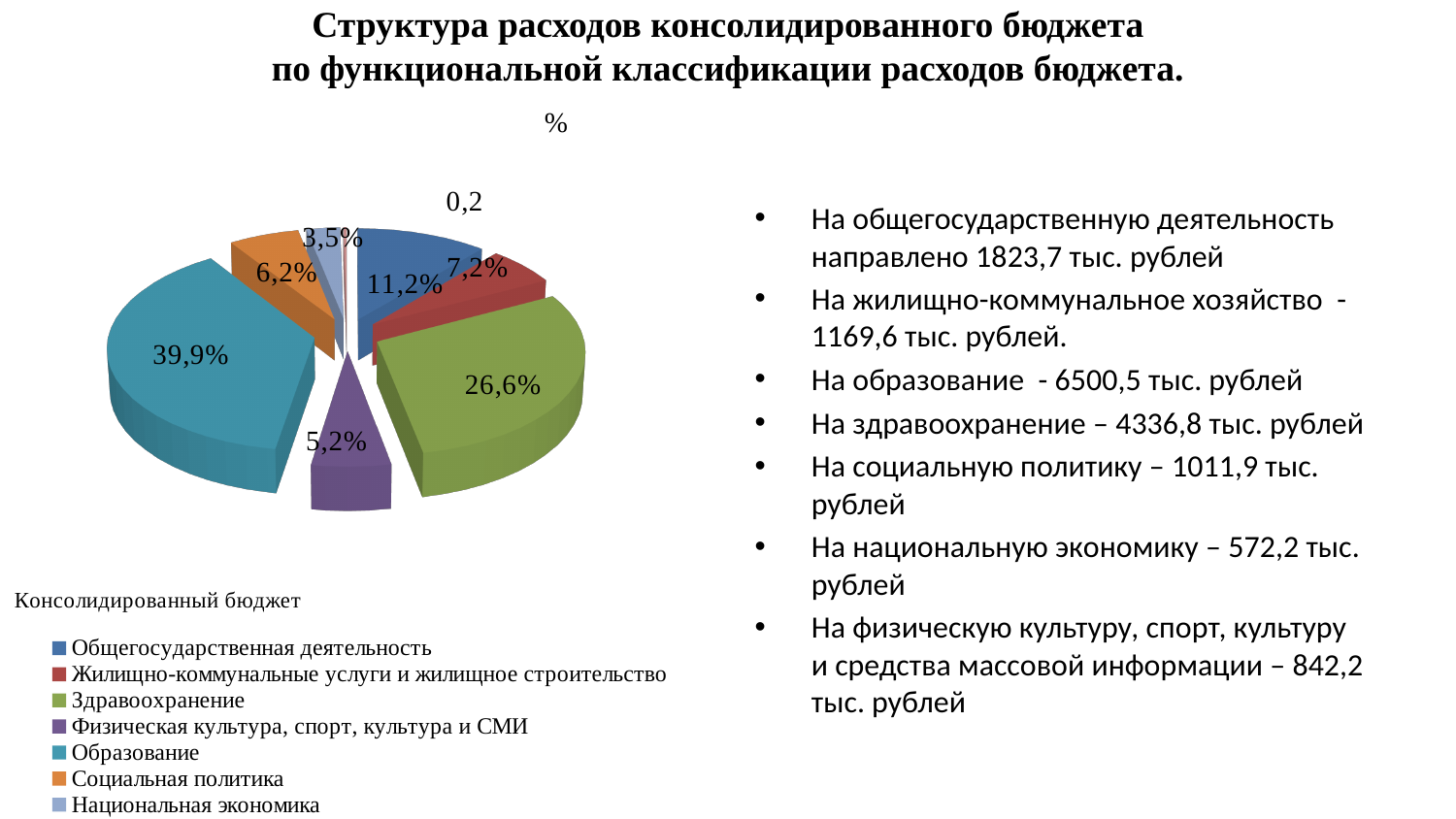
What share of the pie does Образование have? 39,9% What share of the pie does Социальная политика have? 6,2% What share of the pie does Общегосударственная деятельность have? 11,2% What kind of chart is shown on the slide? pie chart Which category has the largest slice of the pie? Образование What share of the pie does Физическая культура, спорт, культура и СМИ have? 5,2% What is the difference between the shares of Образование and Здравоохранение? 13,3% What share of the pie does Жилищно-коммунальные услуги и жилищное строительство have? 7,2% How many entries does the chart legend list? 7 What share of the pie does Национальная экономика have? 3,5% Which has the larger share: Социальная политика or Жилищно-коммунальные услуги и жилищное строительство? Жилищно-коммунальные услуги и жилищное строительство What share of the pie does Здравоохранение have? 26,6%